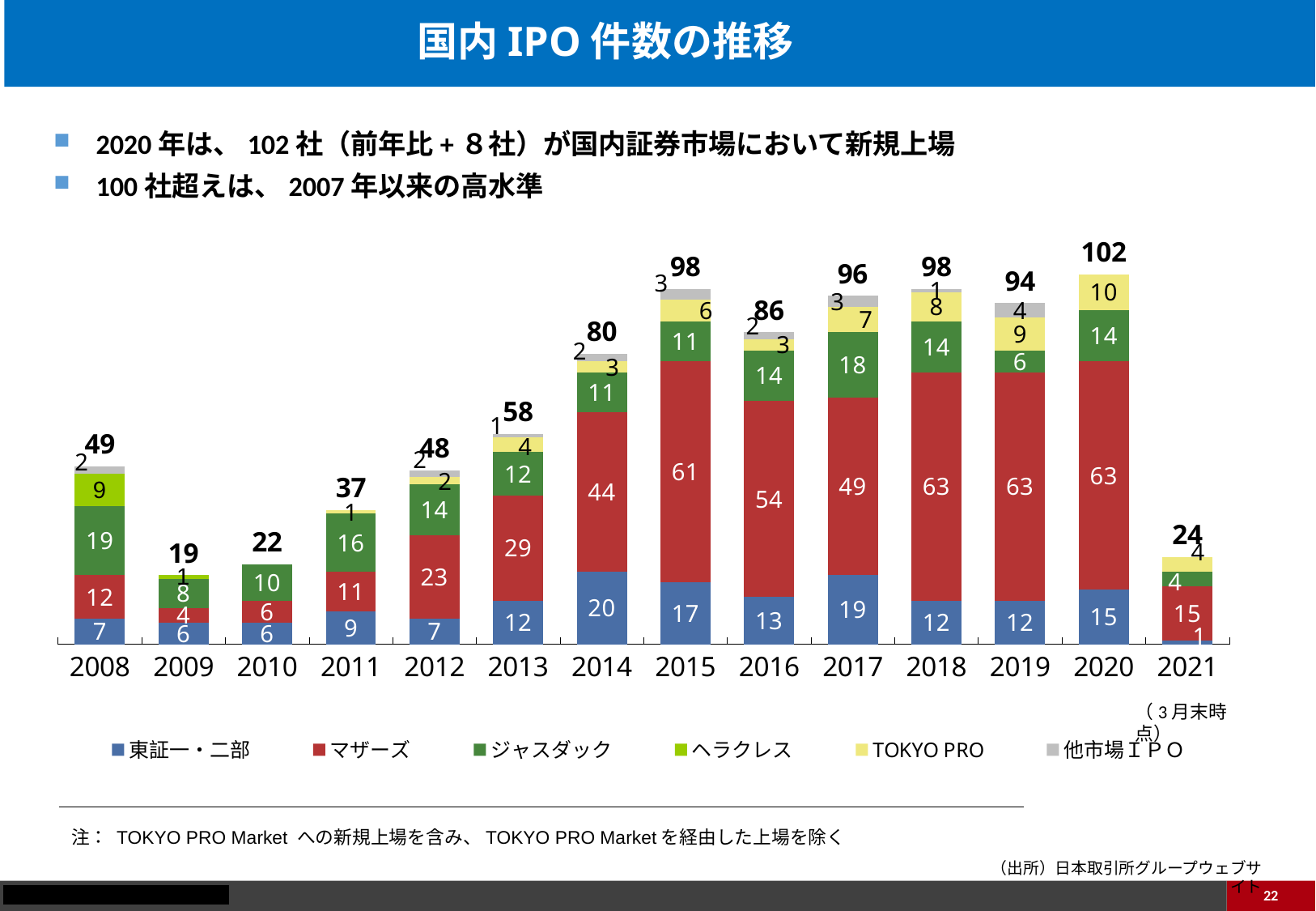
What is the value for マザーズ in 2015? 61 What is the total number of IPOs for 2020? 102 Which year has the highest total number of IPOs? 2020 Which series is shown in red in the legend? マザーズ How many series does the legend list? 6 What is the difference between the total for 2020 and the total for 2019? 8 What is the value for 東証一・二部 in 2014? 20 Which is larger, the ジャスダック value in 2017 or the ジャスダック value in 2019? 2017 How many years are shown on the x axis? 14 What is the value for TOKYO PRO in 2020? 10 Which year has the lowest total number of IPOs? 2009 What type of chart is shown on the slide? stacked bar chart